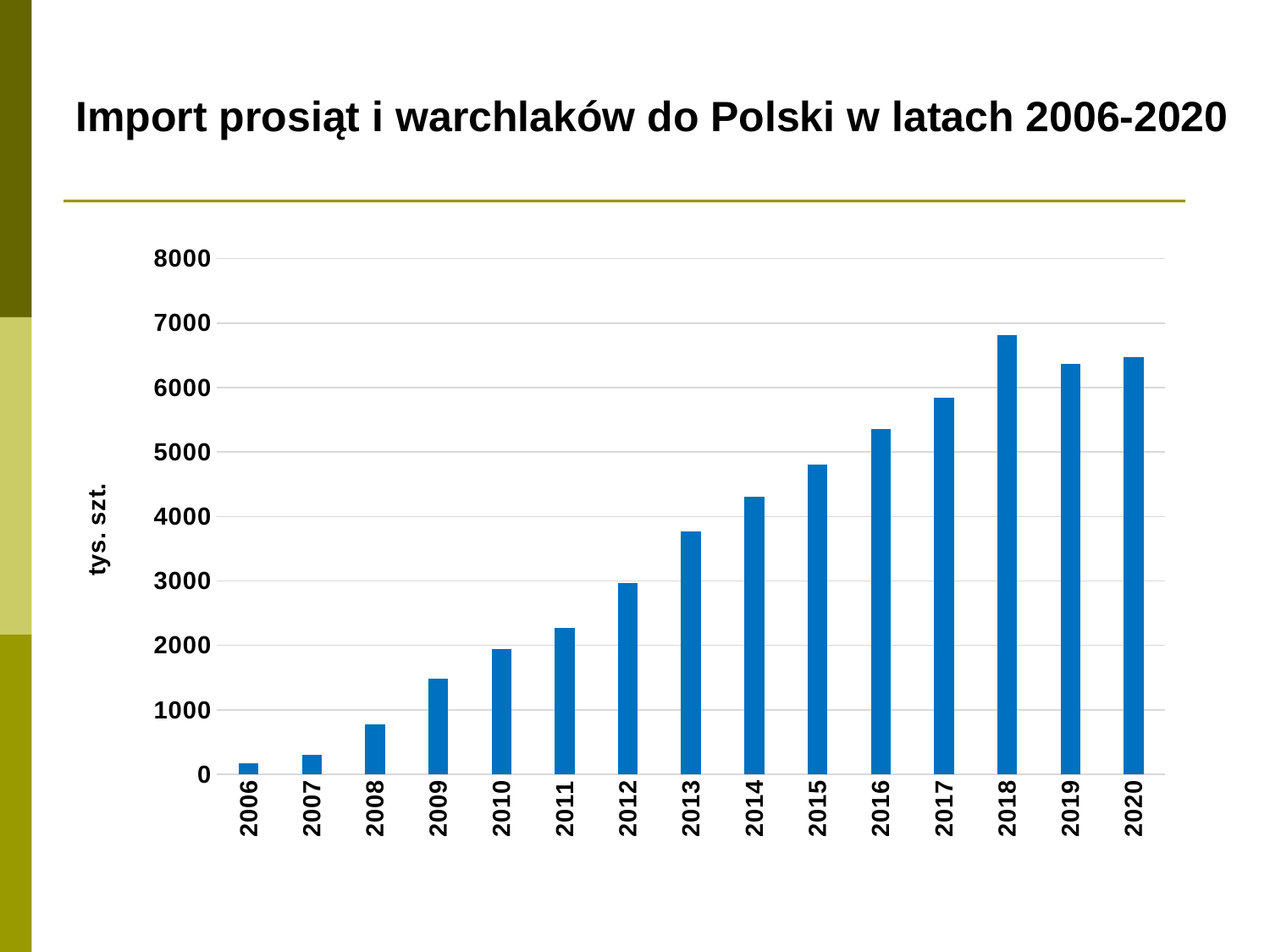
Which year has the lowest import value? 2006 Which is larger, the value for 2018 or the value for 2019? 2018 Is the value for 2016 greater or less than 5000? greater Is the value for 2008 greater or less than 1000? less What type of chart is shown on the slide? bar chart Is the value for 2014 greater or less than 4000? greater Which year has the highest import value? 2018 What unit is shown on the vertical axis label? tys. szt. Do the values generally rise or fall from 2006 to 2018? rise How many years (bars) are shown in the chart? 15